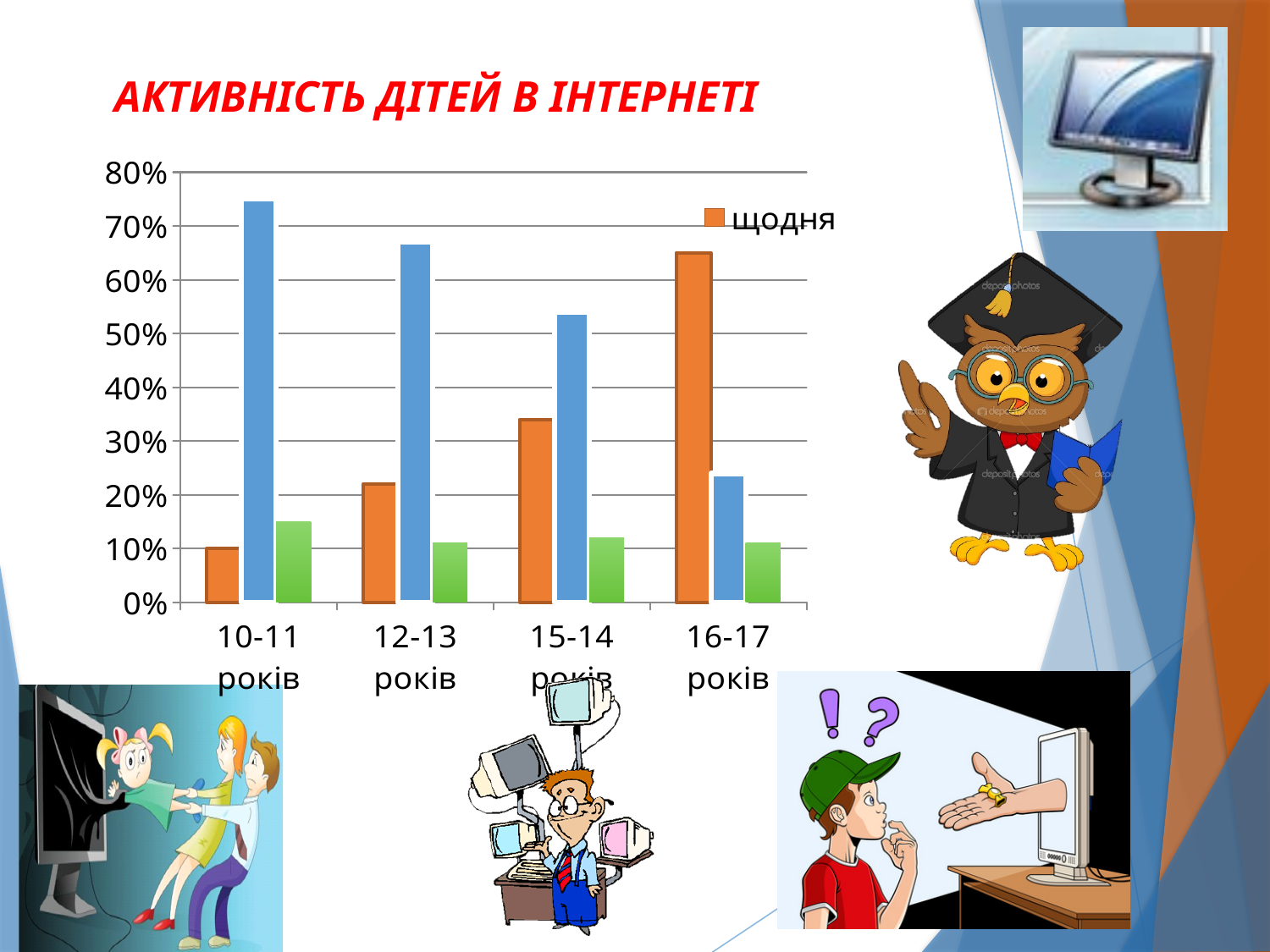
What kind of chart is shown on the slide? bar chart Is the 'щодня' (orange) value for 10-11 років greater or less than 20%? less What is the title of the slide with the chart? АКТИВНІСТЬ ДІТЕЙ В ІНТЕРНЕТІ For 16-17 років, which is larger: the orange 'щодня' bar or the blue bar? the orange 'щодня' bar Which age group has the lowest value for the 'щодня' (orange) series? 10-11 років Is the blue bar for 10-11 років greater or less than 70%? greater Do the 'щодня' (orange) values rise or fall from 10-11 років to 16-17 років? rise How many age-group categories are shown on the x axis of the chart? 4 Which age group has the highest value for the 'щодня' (orange) series? 16-17 років Is the 'щодня' (orange) value for 16-17 років greater or less than 60%? greater Which age group has the highest blue bar? 10-11 років Which series name is shown in the chart's legend? щодня